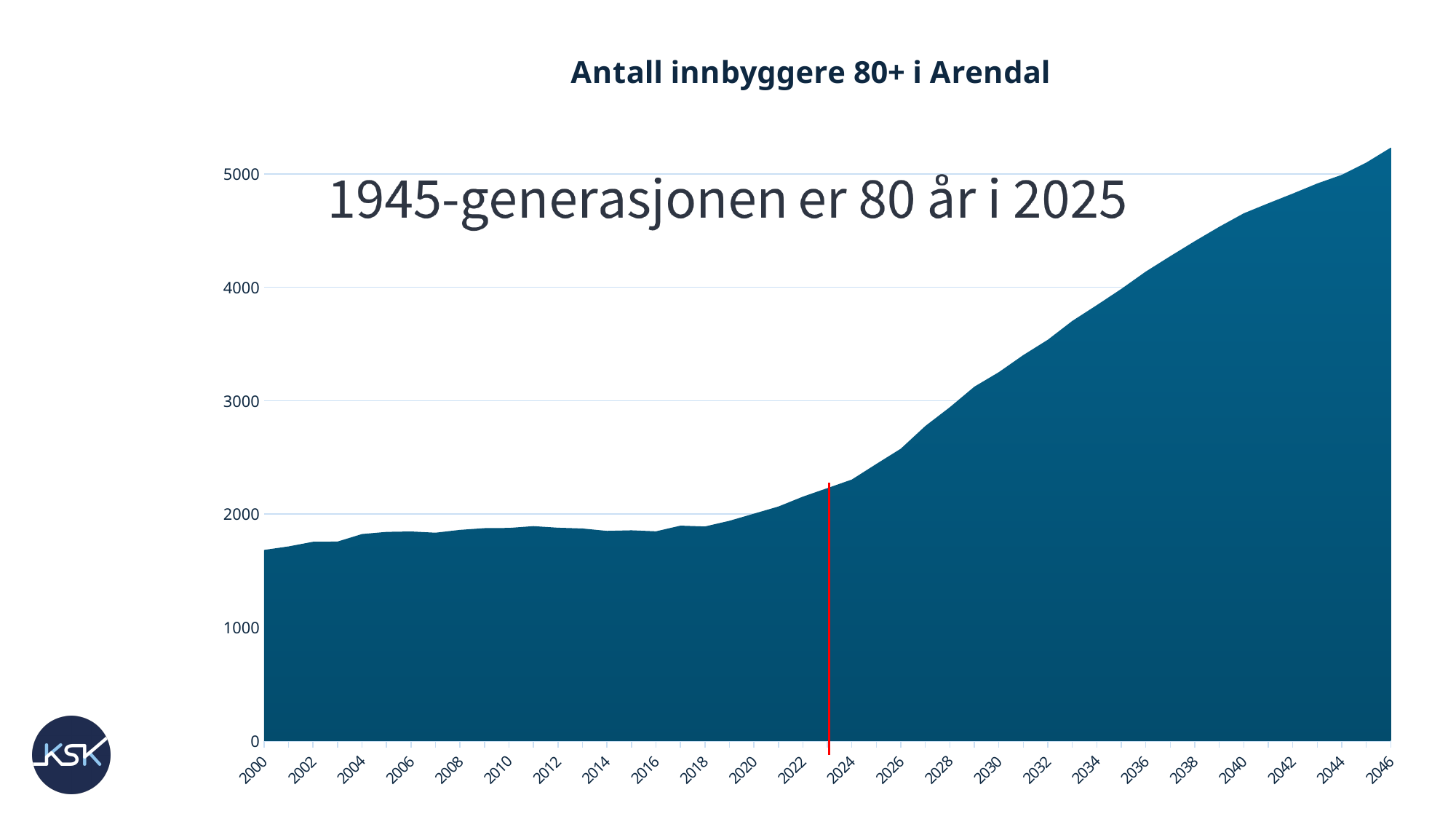
Is the value for 2046 greater or less than 5000? greater Is the value for 2040 greater or less than 4000? greater Is the value for 2030 greater or less than 3000? greater What is the title of the chart? Antall innbyggere 80+ i Arendal What text is written across the chart area above the plotted data? 1945-generasjonen er 80 år i 2025 What kind of chart is shown on the slide? area chart How many year labels are shown on the x axis? 24 Which is larger, the value for 2010 or the value for 2030? 2030 Which year shown on the x axis has the highest value? 2046 Do the values generally rise or fall from 2020 to 2046? rise Which year shown on the x axis has the lowest value? 2000